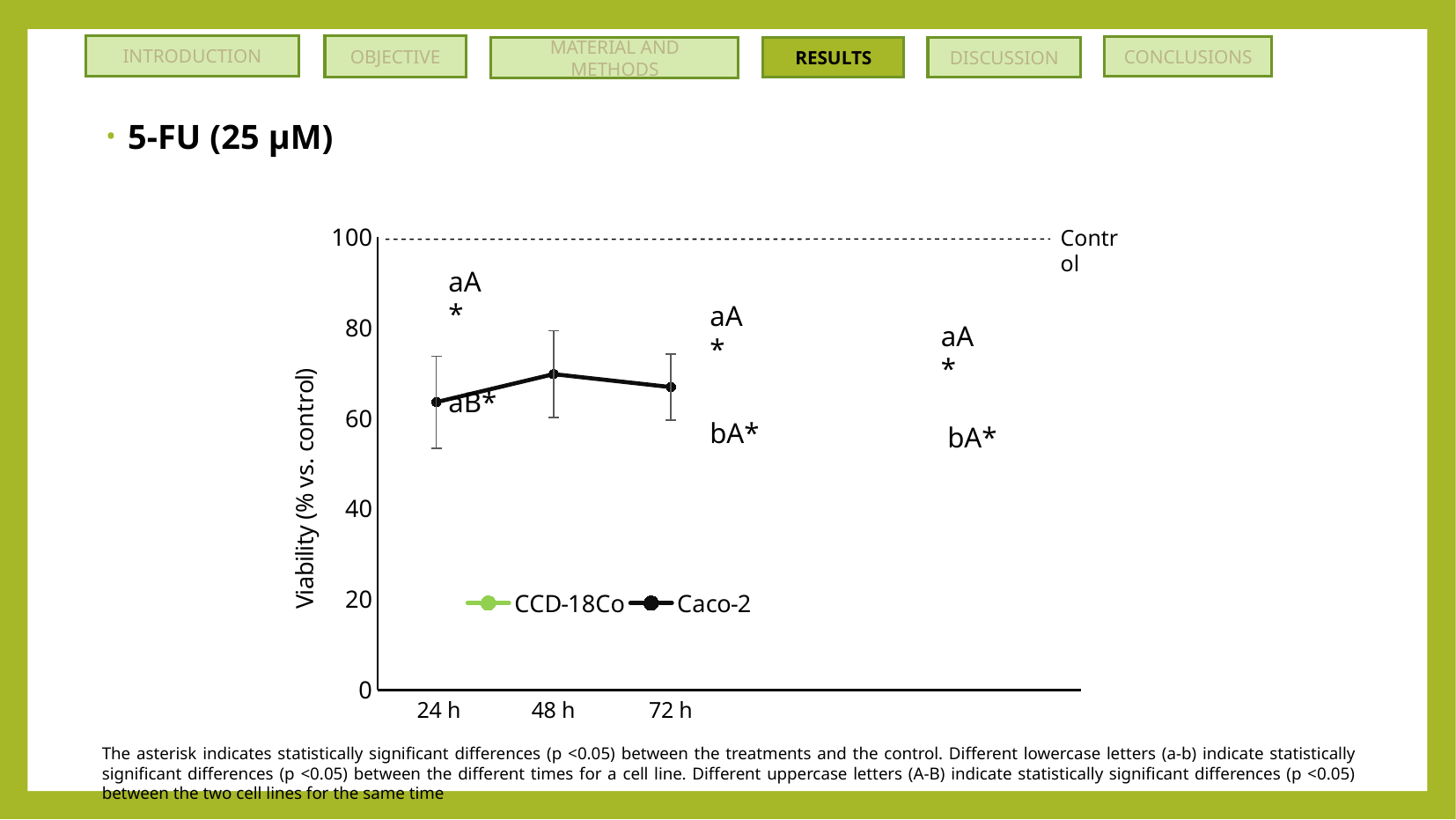
Is the Caco-2 viability at 72 h greater or less than 80? less Is the Caco-2 viability at 24 h greater or less than 80? less What is the label of the y axis? Viability (% vs. control) Does the Caco-2 viability rise or fall from 24 h to 48 h? rise Is the Caco-2 viability at 48 h greater or less than the control line at 100? less What kind of chart is shown on the slide? line chart At which time point is the Caco-2 viability highest? 48 h How many series does the legend list? 2 Which two cell lines are listed in the legend? CCD-18Co and Caco-2 How many time points are shown on the x axis? 3